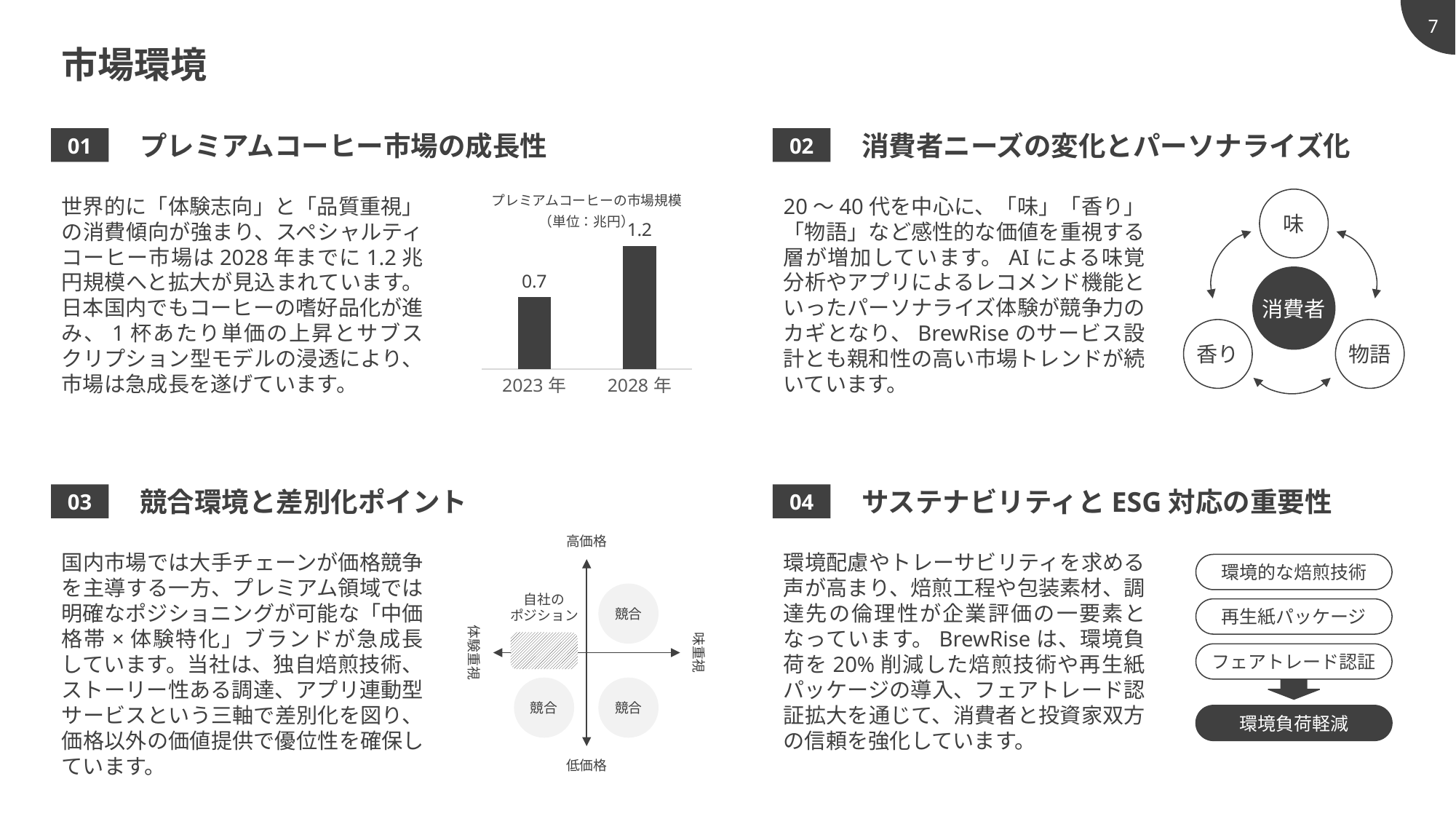
What is the value for 2023 年 in the プレミアムコーヒーの市場規模 chart? 0.7 What unit is stated for the values in the プレミアムコーヒーの市場規模 chart? 兆円 Do the values in the プレミアムコーヒーの市場規模 chart rise or fall from 2023 年 to 2028 年? Rise Which year has the lowest value in the プレミアムコーヒーの市場規模 chart? 2023 年 What is the title of the bar chart on the slide? プレミアムコーヒーの市場規模 What is the difference between the 2028 年 and 2023 年 values in the プレミアムコーヒーの市場規模 chart? 0.5 What kind of chart is the プレミアムコーヒーの市場規模 chart? Bar chart Which year has the highest value in the プレミアムコーヒーの市場規模 chart? 2028 年 How many categories (years) are shown in the プレミアムコーヒーの市場規模 chart? 2 In the プレミアムコーヒーの市場規模 chart, which is larger, the value for 2023 年 or 2028 年? 2028 年 What is the value for 2028 年 in the プレミアムコーヒーの市場規模 chart? 1.2